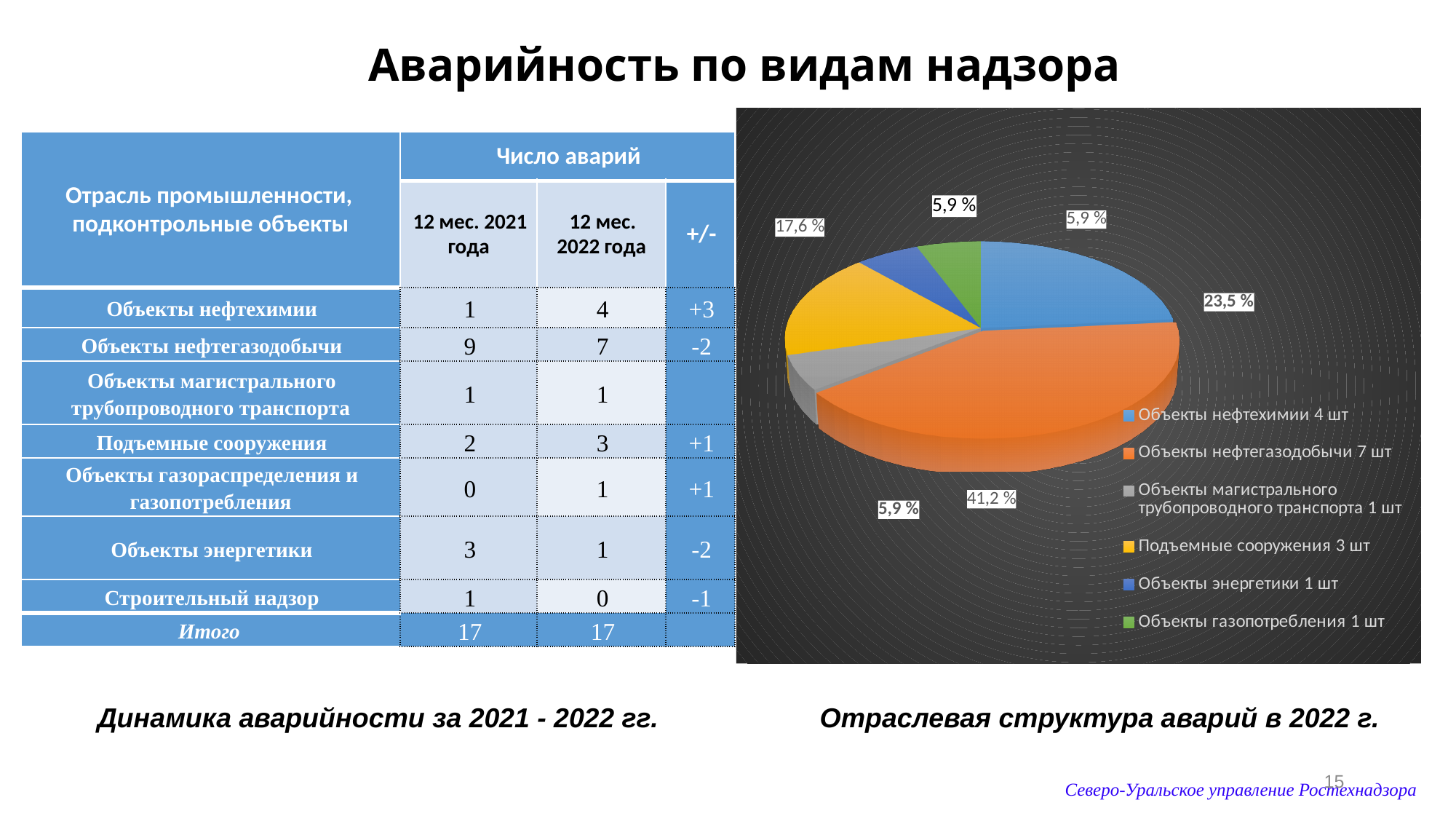
What is the title of the chart on the slide? Отраслевая структура аварий в 2022 г. What share of the pie does Объекты нефтегазодобычи have? 41,2 % What share of the pie does Объекты нефтехимии have? 23,5 % What is the difference in share between Объекты нефтегазодобычи and Объекты нефтехимии? 17,7 % Which has the larger share of the pie: Объекты нефтехимии or Подъемные сооружения? Объекты нефтехимии What share of the pie does Объекты энергетики have? 5,9 % What kind of chart is shown on the slide? pie chart Which category has the largest share of the pie chart? Объекты нефтегазодобычи How many categories does the legend of the pie chart list? 6 According to the legend, how many accidents (шт) are attributed to Объекты нефтегазодобычи? 7 шт According to the legend, how many accidents (шт) are attributed to Подъемные сооружения? 3 шт